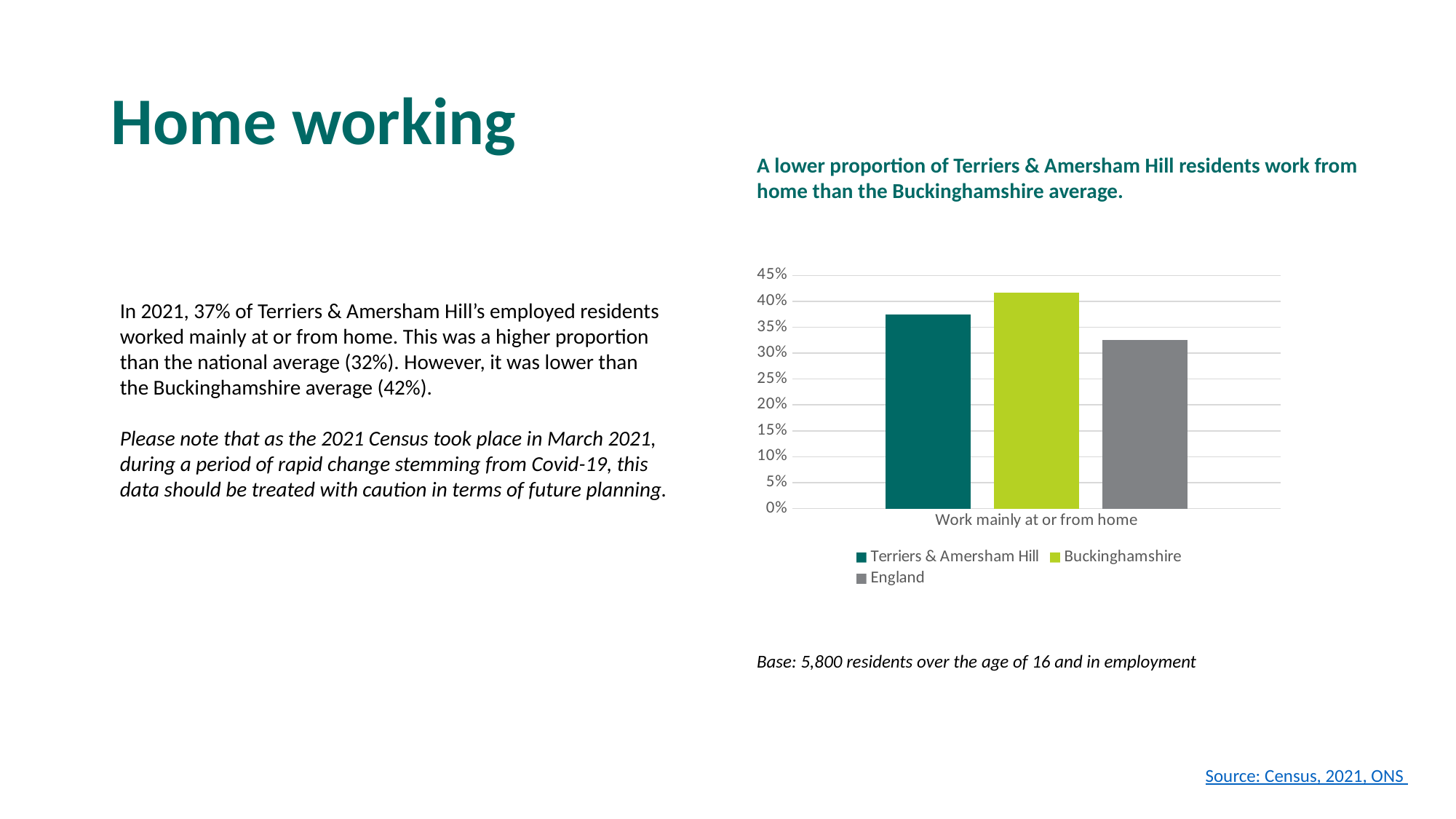
Which is larger, the bar for Buckinghamshire or the bar for Terriers & Amersham Hill? Buckinghamshire Is the bar for Buckinghamshire greater or less than 40%? greater Which series has the highest bar in the chart? Buckinghamshire What kind of chart is shown on the slide? bar chart Is the bar for England greater or less than 35%? less Which is larger, the bar for Terriers & Amersham Hill or the bar for England? Terriers & Amersham Hill Which series has the lowest bar in the chart? England What is the category label shown on the x axis of the chart? Work mainly at or from home What is the highest value shown on the chart's y axis? 45% Is the bar for Terriers & Amersham Hill greater or less than 35%? greater How many series does the chart legend list? 3